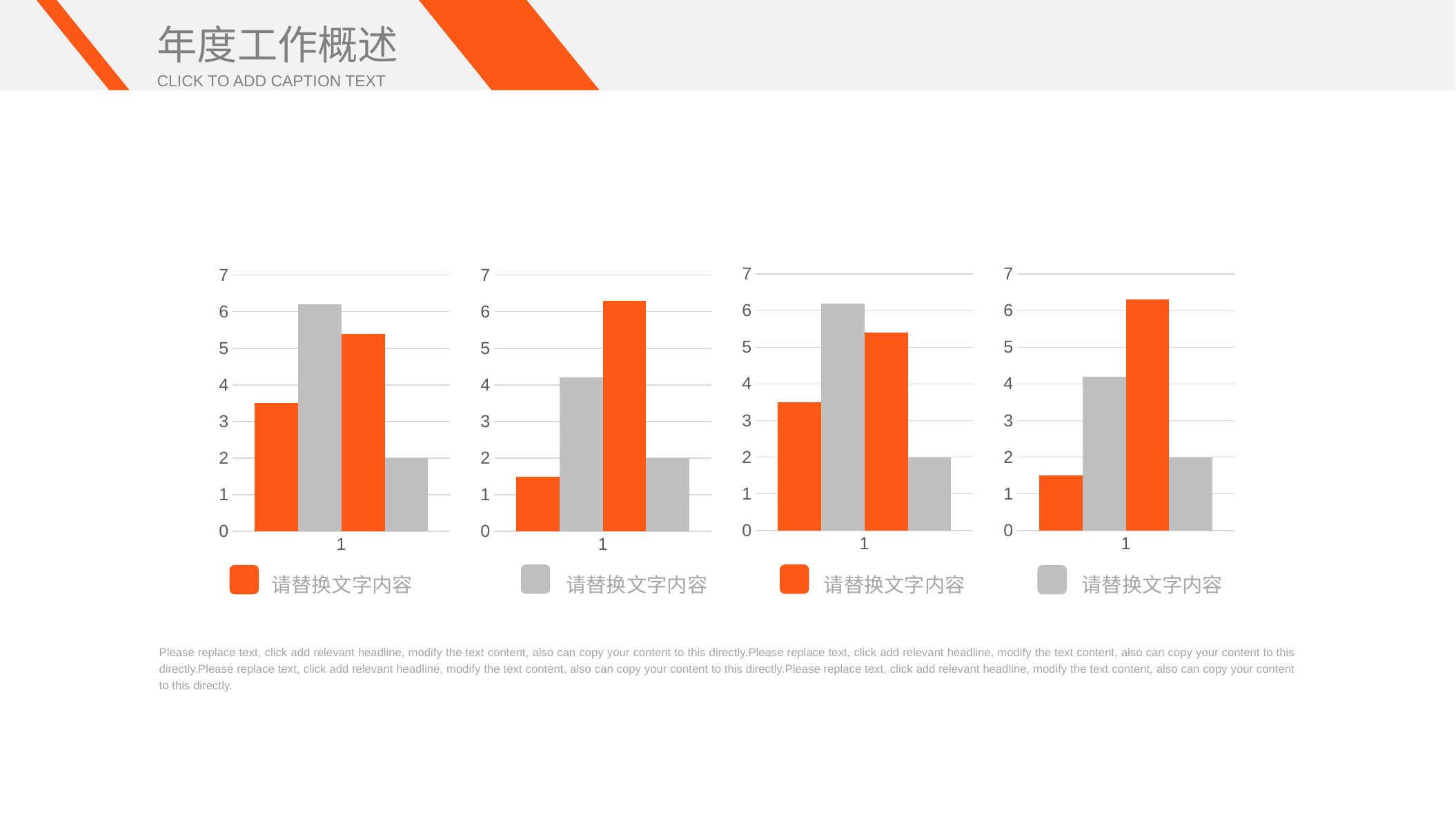
In the second chart from the left, is the value of the first (orange) bar greater or less than 2? less In the second chart from the left, which bar is the tallest: the first, second, third or fourth from the left? third In the leftmost chart, is the value of the second (gray) bar greater or less than 6? greater In the leftmost chart, how many bars are plotted? 4 In the leftmost chart, which bar is the tallest: the first, second, third or fourth from the left? second In the leftmost chart, what is the value of the fourth (gray) bar, which lands on an axis tick? 2 In the leftmost chart, which bar is the shortest: the first, second, third or fourth from the left? fourth What kind of chart is the leftmost chart on the slide? bar chart In the leftmost chart, what is the label of the single category on the x axis? 1 In the leftmost chart, is the value of the first (orange) bar greater or less than 3? greater In the second chart from the left, which bar is the shortest: the first, second, third or fourth from the left? first In the second chart from the left, which is larger: the second (gray) bar or the third (orange) bar? the third (orange) bar